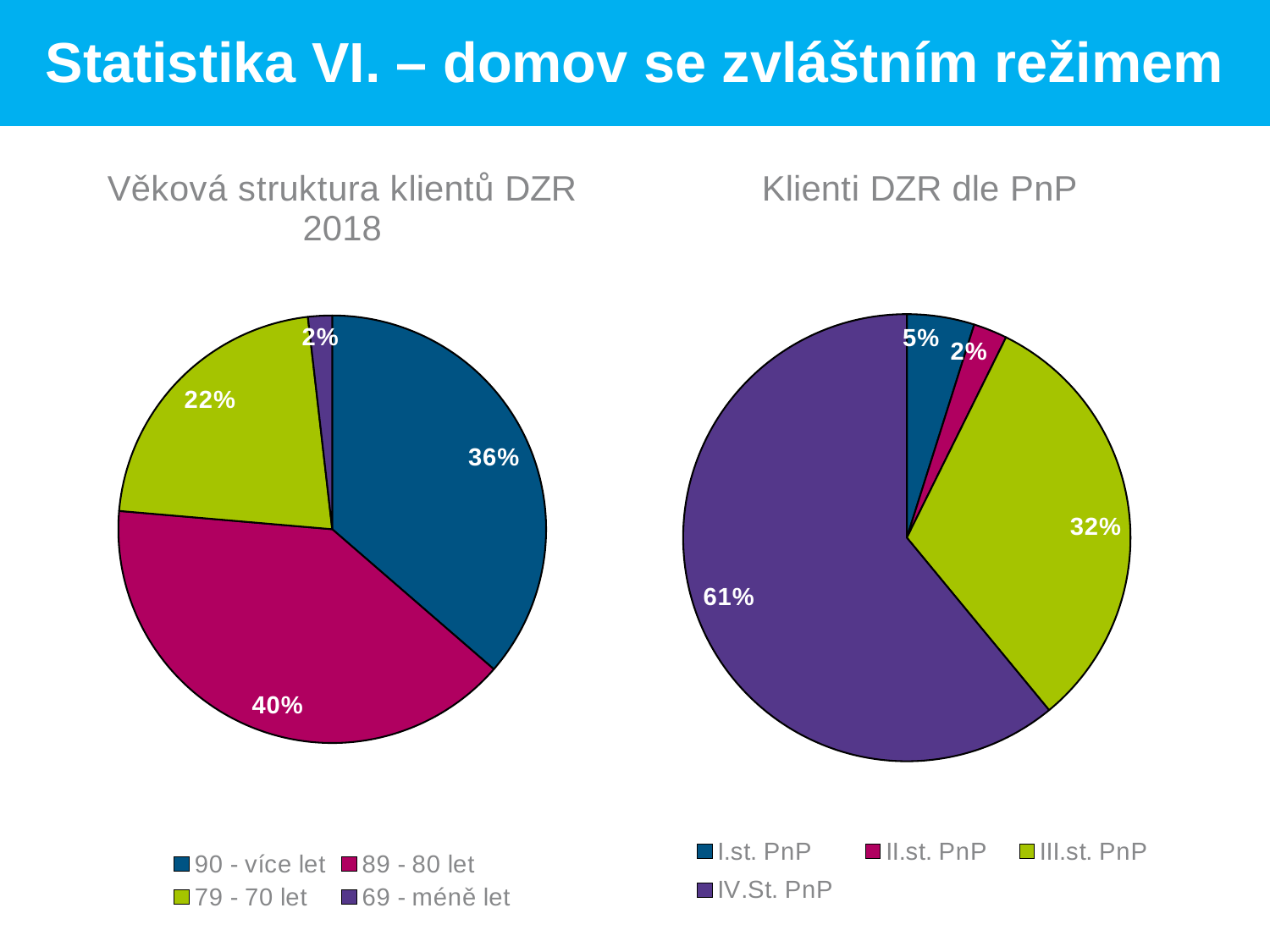
In the chart titled "Klienti DZR dle PnP", what is the difference in percentage points between "IV.St. PnP" and "III.st. PnP"? 29 In the chart titled "Věková struktura klientů DZR 2018", what share of clients are in the "90 - více let" group? 36% In the chart titled "Klienti DZR dle PnP", what share of clients are in "III.st. PnP"? 32% In the chart titled "Věková struktura klientů DZR 2018", how many age groups are shown? 4 In the chart titled "Klienti DZR dle PnP", which category has the smallest share? II.st. PnP In the chart titled "Věková struktura klientů DZR 2018", what is the difference in percentage points between the "89 - 80 let" and "79 - 70 let" groups? 18 In the chart titled "Věková struktura klientů DZR 2018", which age group has the largest share? 89 - 80 let In the chart titled "Klienti DZR dle PnP", which is larger: the share for "I.st. PnP" or "II.st. PnP"? I.st. PnP In the chart titled "Věková struktura klientů DZR 2018", which age group has the smallest share? 69 - méně let What type of chart is the chart titled "Klienti DZR dle PnP"? Pie chart In the chart titled "Klienti DZR dle PnP", what share of clients are in "IV.St. PnP"? 61% In the chart titled "Věková struktura klientů DZR 2018", what share of clients are in the "89 - 80 let" group? 40%